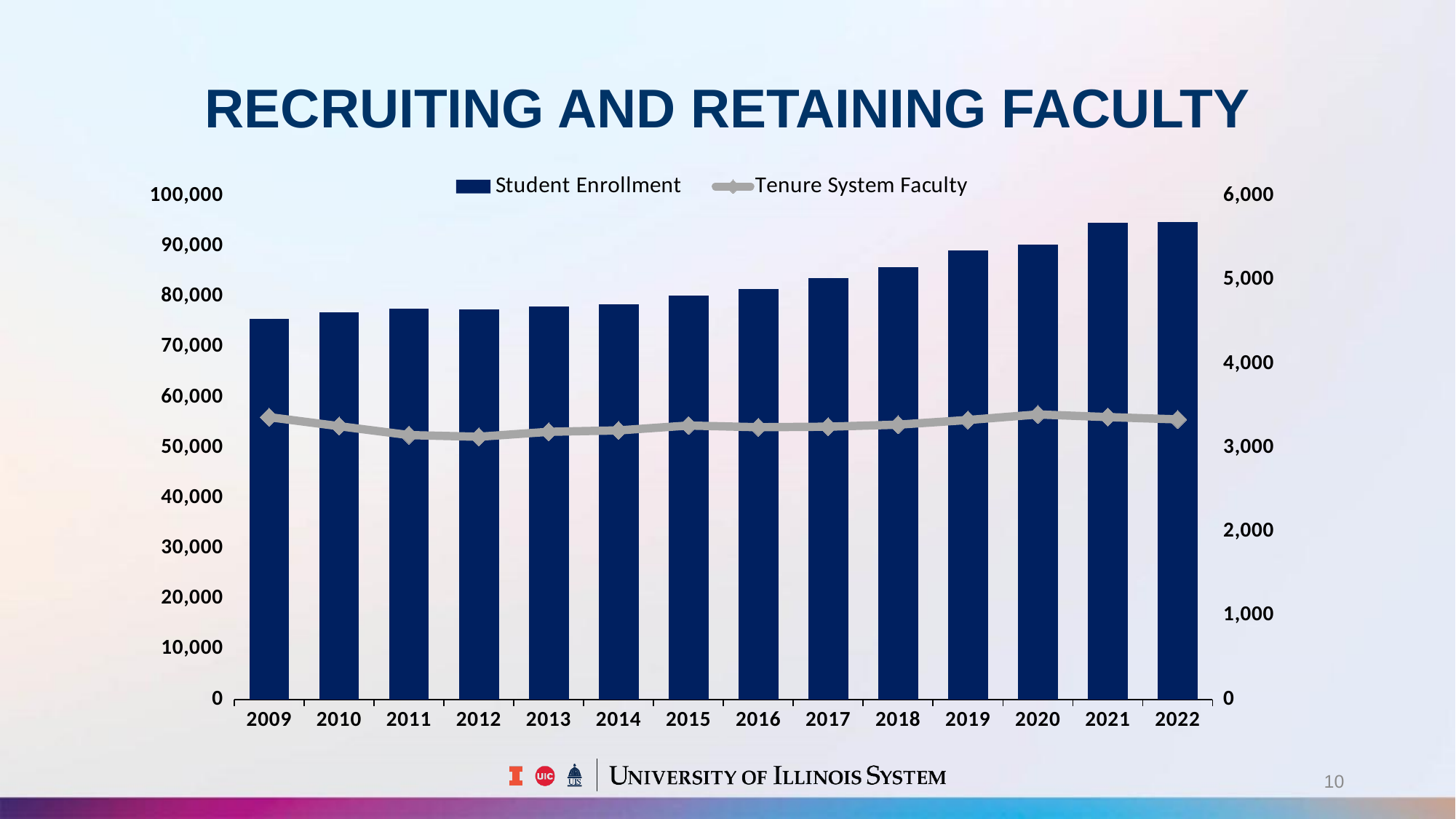
Is the Student Enrollment value for 2017 greater or less than 80,000? greater What kind of chart is used for Student Enrollment? Bar chart How many years are shown on the x axis? 14 Does Student Enrollment generally rise or fall from 2009 to 2022? Rise What is the title of the slide containing the chart? RECRUITING AND RETAINING FACULTY Is the Tenure System Faculty value for 2020 greater or less than 4,000? less Is the Student Enrollment value for 2009 greater or less than 80,000? less Which year has the larger Student Enrollment, 2013 or 2017? 2017 Which year has the larger Tenure System Faculty value, 2012 or 2020? 2020 How many series does the legend list? 2 Which year has the larger Student Enrollment, 2009 or 2022? 2022